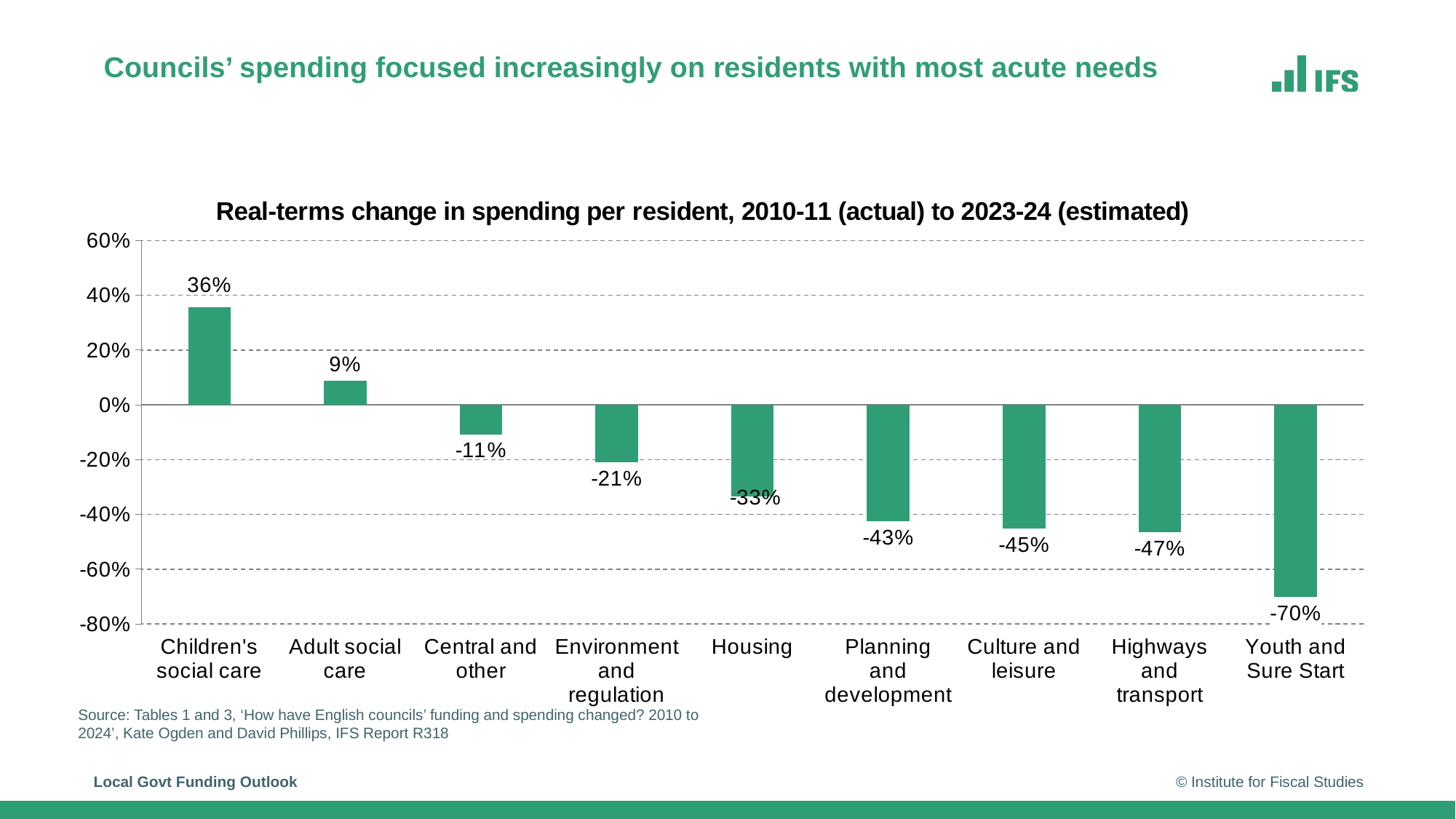
How many categories are shown on the chart? 9 What is the real-terms change in spending per resident for Children's social care? 36% What is the value shown for Highways and transport? -47% Do the values rise or fall moving from left to right along the x axis? Fall Which category has the lowest real-terms change in spending per resident? Youth and Sure Start Which category has the highest real-terms change in spending per resident? Children's social care Which has a larger value, Central and other or Environment and regulation? Central and other What is the value shown for Housing? -33% How many categories show a positive real-terms change in spending per resident? 2 What is the difference between the values for Children's social care and Adult social care? 27 percentage points What kind of chart is shown on the slide? Bar chart What is the title of the chart? Real-terms change in spending per resident, 2010-11 (actual) to 2023-24 (estimated)